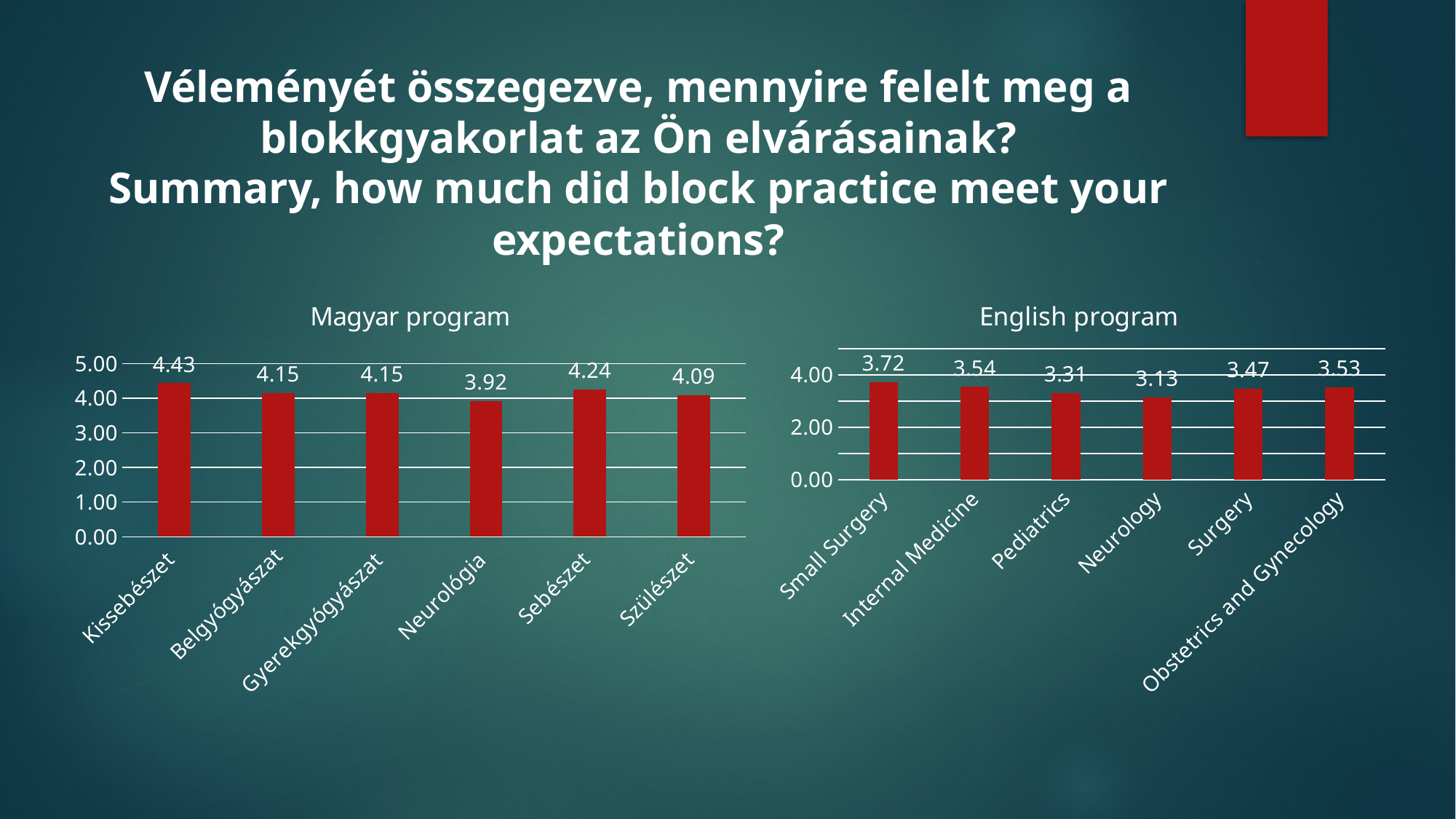
What kind of chart is the Magyar program chart? Bar chart In the English program chart, which is larger, the value for Internal Medicine or the value for Surgery? Internal Medicine In the English program chart, which category has the lowest value? Neurology In the English program chart, what is the difference between the values for Small Surgery and Neurology? 0.59 In the English program chart, what is the value for Obstetrics and Gynecology? 3.53 In the Magyar program chart, what is the difference between the values for Kissebészet and Neurológia? 0.51 In the Magyar program chart, what is the value for Kissebészet? 4.43 In the Magyar program chart, which category has the highest value? Kissebészet How many categories are shown in the English program chart? 6 In the English program chart, which category has the highest value? Small Surgery In the English program chart, what is the value for Pediatrics? 3.31 In the Magyar program chart, what is the value for Neurológia? 3.92